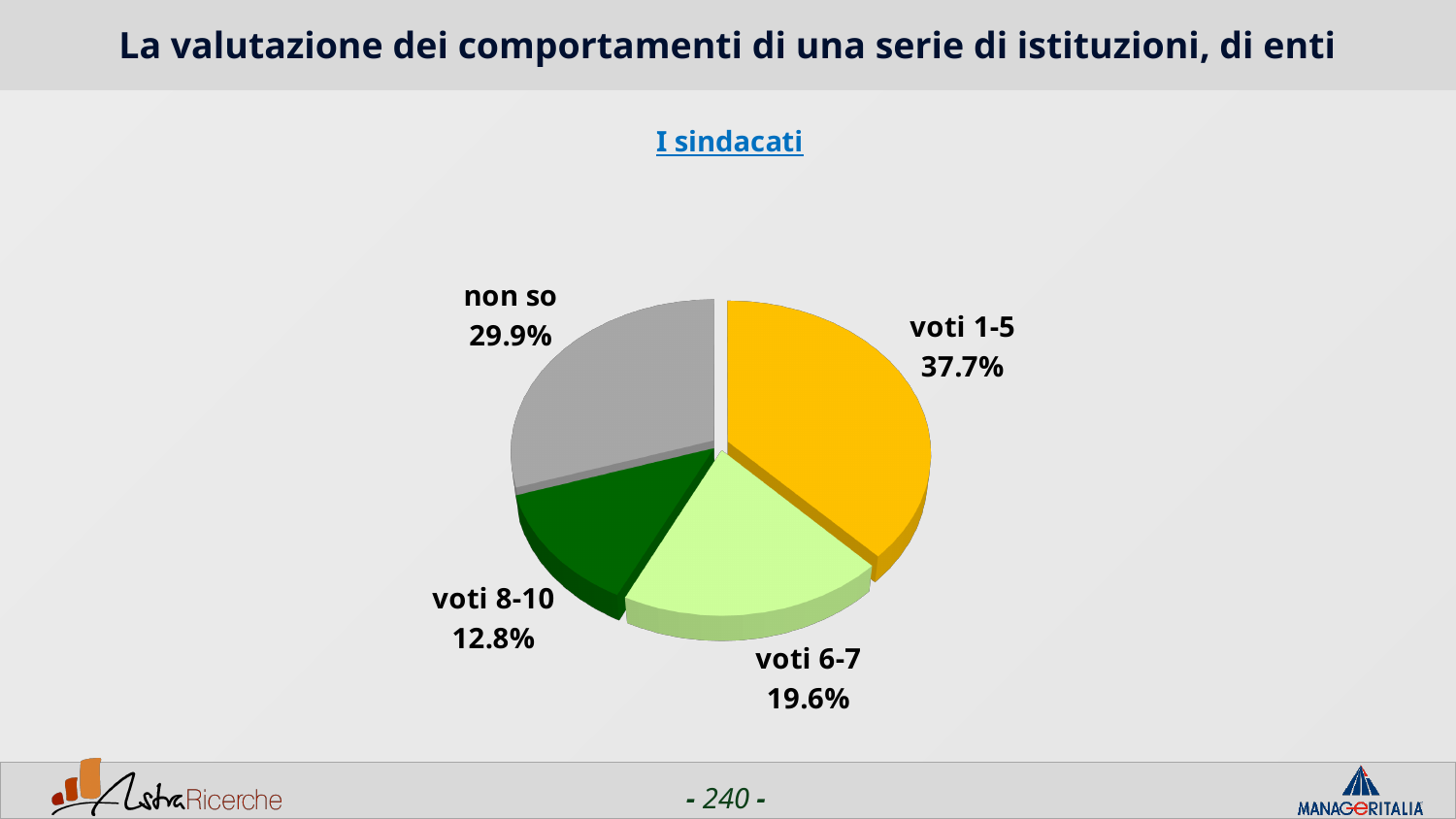
What is the difference in percentage points between 'voti 6-7' and 'voti 8-10'? 6.8 Which slice of the pie is the smallest? voti 8-10 What percentage is shown for 'non so'? 29.9% What kind of chart is shown on the slide? pie chart What is the subtitle of the chart, shown above the pie? I sindacati What percentage is shown for 'voti 1-5'? 37.7% Which slice of the pie is the largest? voti 1-5 How many slices does the pie chart have? 4 What percentage is shown for 'voti 8-10'? 12.8% What is the difference in percentage points between 'voti 1-5' and 'non so'? 7.8 What percentage is shown for 'voti 6-7'? 19.6% Which is larger, 'non so' or 'voti 6-7'? non so